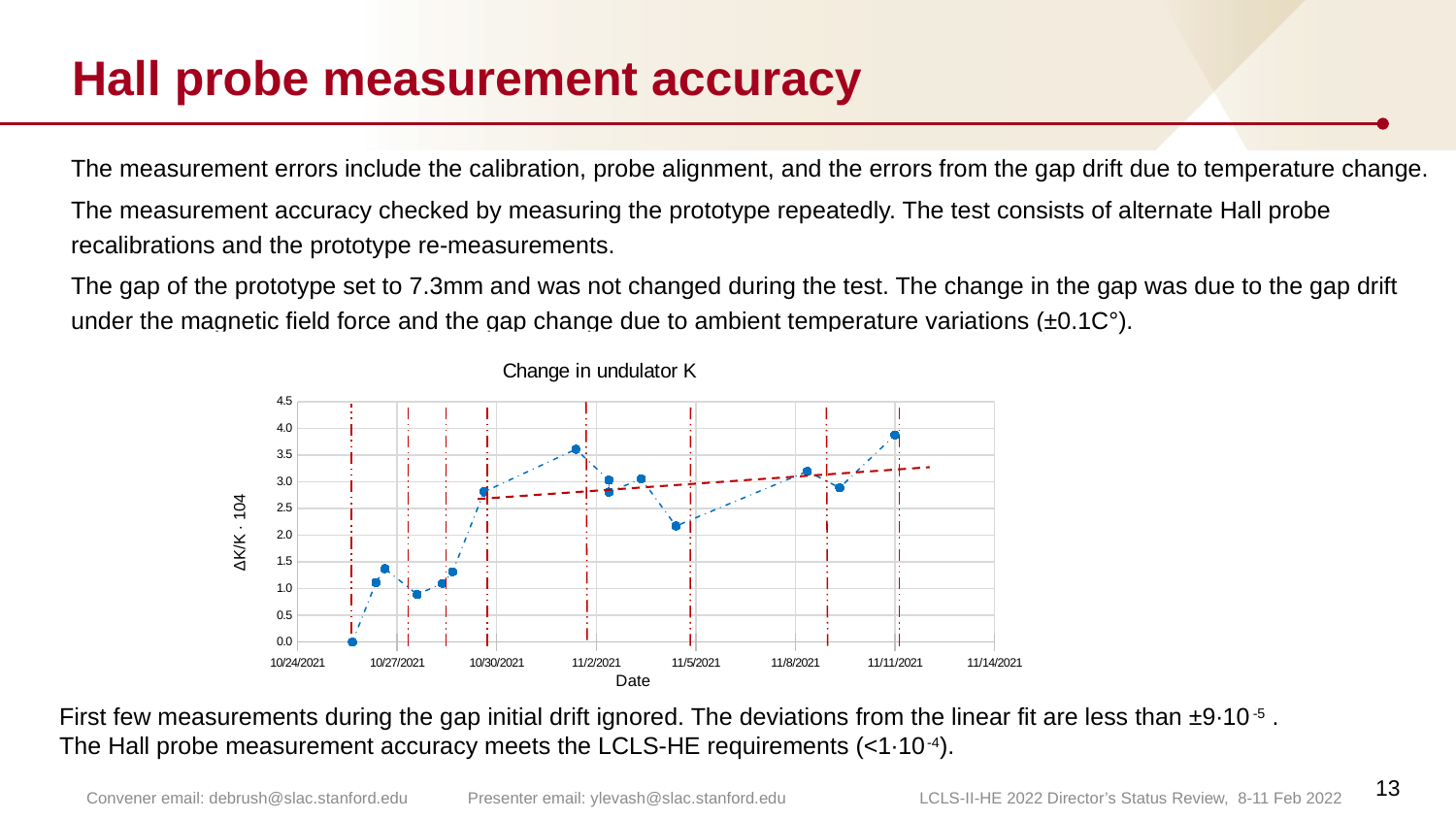
Which is larger: the plotted value near 11/2/2021 or the plotted value near 11/5/2021? 11/2/2021 What is the value of the first (leftmost) plotted point? 0.0 Is the value of the plotted point near 11/11/2021 greater or less than 3.5? greater Is the value of the plotted point near 10/27/2021 greater or less than 1.5? less What is the label of the x axis of the chart? Date Is the value of the plotted point near 11/5/2021 greater or less than 2.5? less What kind of chart is shown on the slide? line chart What is the title of the chart? Change in undulator K Around which date does the highest plotted point occur? 11/11/2021 Do the plotted values generally rise or fall from left to right along the date axis? rise Does the red dashed linear fit line rise or fall from left to right? rise